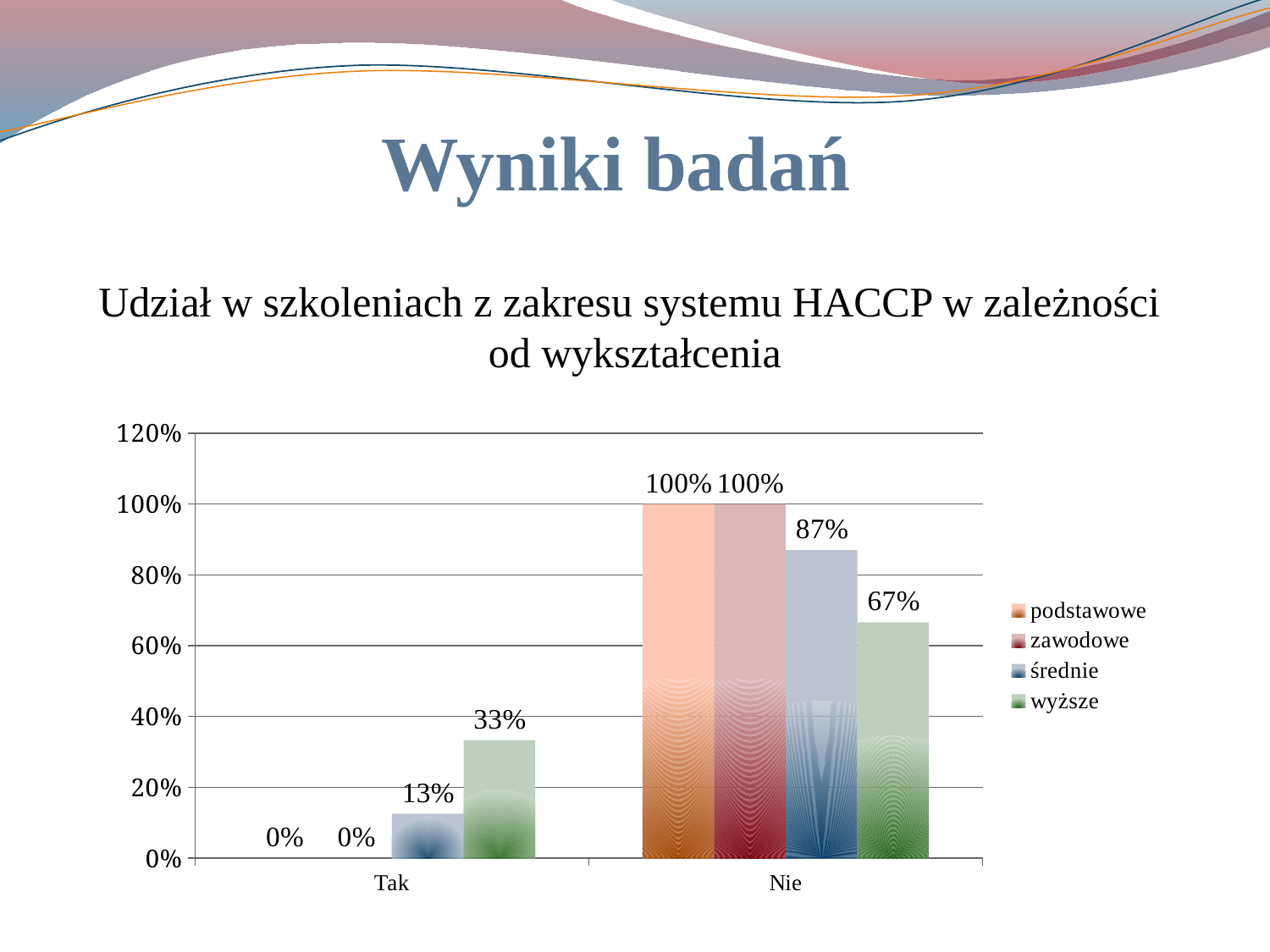
Which series has the lowest value in the Nie category? wyższe What is the value for podstawowe in the Tak category? 0% What is the value for wyższe in the Tak category? 33% How many series does the legend list? 4 What is the difference between the średnie values for Nie and Tak? 74% How many categories are shown on the x axis? 2 What kind of chart is shown on the slide? bar chart Which series has the highest value in the Tak category? wyższe What is the value for wyższe in the Nie category? 67% Which is larger: the zawodowe value for Nie or the średnie value for Nie? zawodowe What is the value for średnie in the Nie category? 87% What is the title of the chart? Udział w szkoleniach z zakresu systemu HACCP w zależności od wykształcenia